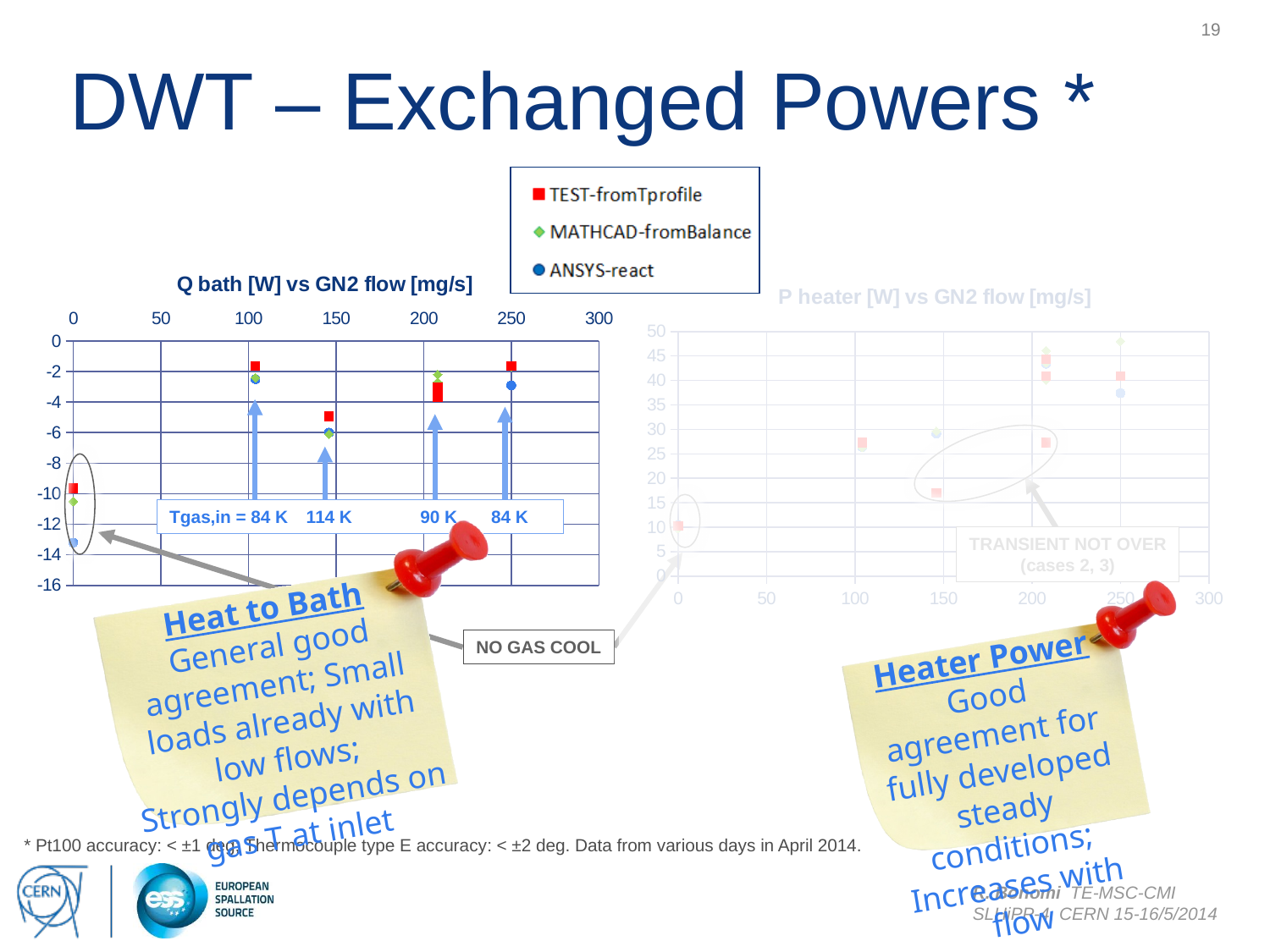
What is the title of the chart on the right of the slide? P heater [W] vs GN2 flow [mg/s] In the "Q bath [W] vs GN2 flow [mg/s]" chart, is the ANSYS-react value at GN2 flow 0 greater or less than -10? less In the "Q bath [W] vs GN2 flow [mg/s]" chart, at which GN2 flow are the Q bath values most negative (lowest)? 0 What kind of chart is the "Q bath [W] vs GN2 flow [mg/s]" chart? scatter chart What are the three series named in the legend? TEST-fromTprofile, MATHCAD-fromBalance, ANSYS-react In the "P heater [W] vs GN2 flow [mg/s]" chart, is the TEST-fromTprofile value at GN2 flow 0 greater or less than 20? less In the "P heater [W] vs GN2 flow [mg/s]" chart, is the MATHCAD-fromBalance value at GN2 flow of about 250 mg/s greater or less than 40? greater What is the maximum value shown on the x axis of the "Q bath [W] vs GN2 flow [mg/s]" chart? 300 How many series does the legend list for the charts? 3 In the "P heater [W] vs GN2 flow [mg/s]" chart, do the heater power values generally rise or fall as GN2 flow increases? rise